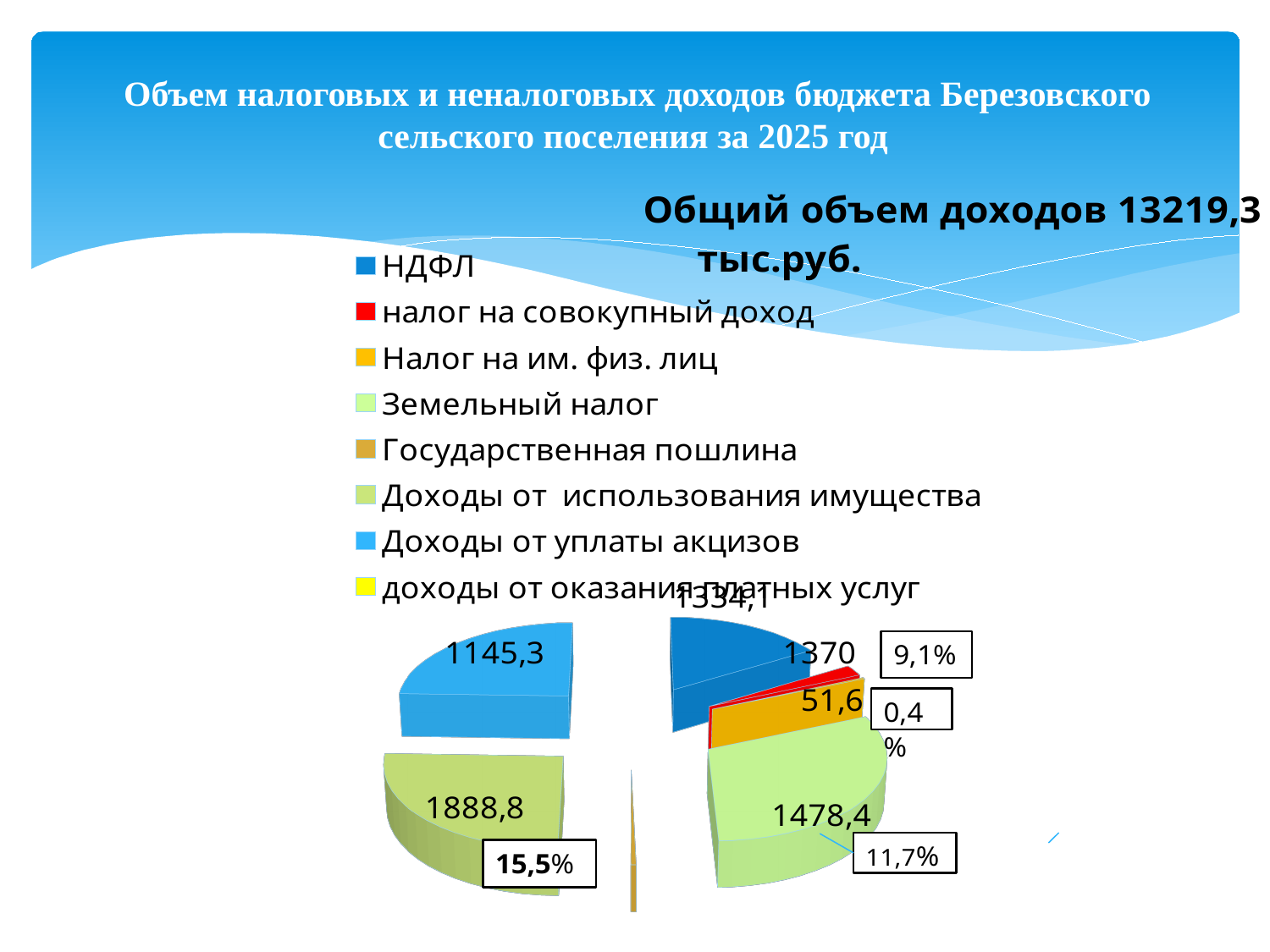
What is the difference between the values for Доходы от использования имущества and Земельный налог? 410,4 Which is larger on the pie chart, Земельный налог or НДФЛ? Земельный налог What value is shown for Доходы от использования имущества on the pie chart? 1888,8 How many entries does the legend of the pie chart list? 8 What value is shown for Земельный налог on the pie chart? 1478,4 What total income amount is stated in the text on the slide? 13219,3 тыс.руб. Which labelled slice of the pie chart has the largest value? Доходы от использования имущества What value is shown for Доходы от уплаты акцизов on the pie chart? 1145,3 What kind of chart is shown on the slide? pie chart What value is shown for Налог на им. физ. лиц on the pie chart? 51,6